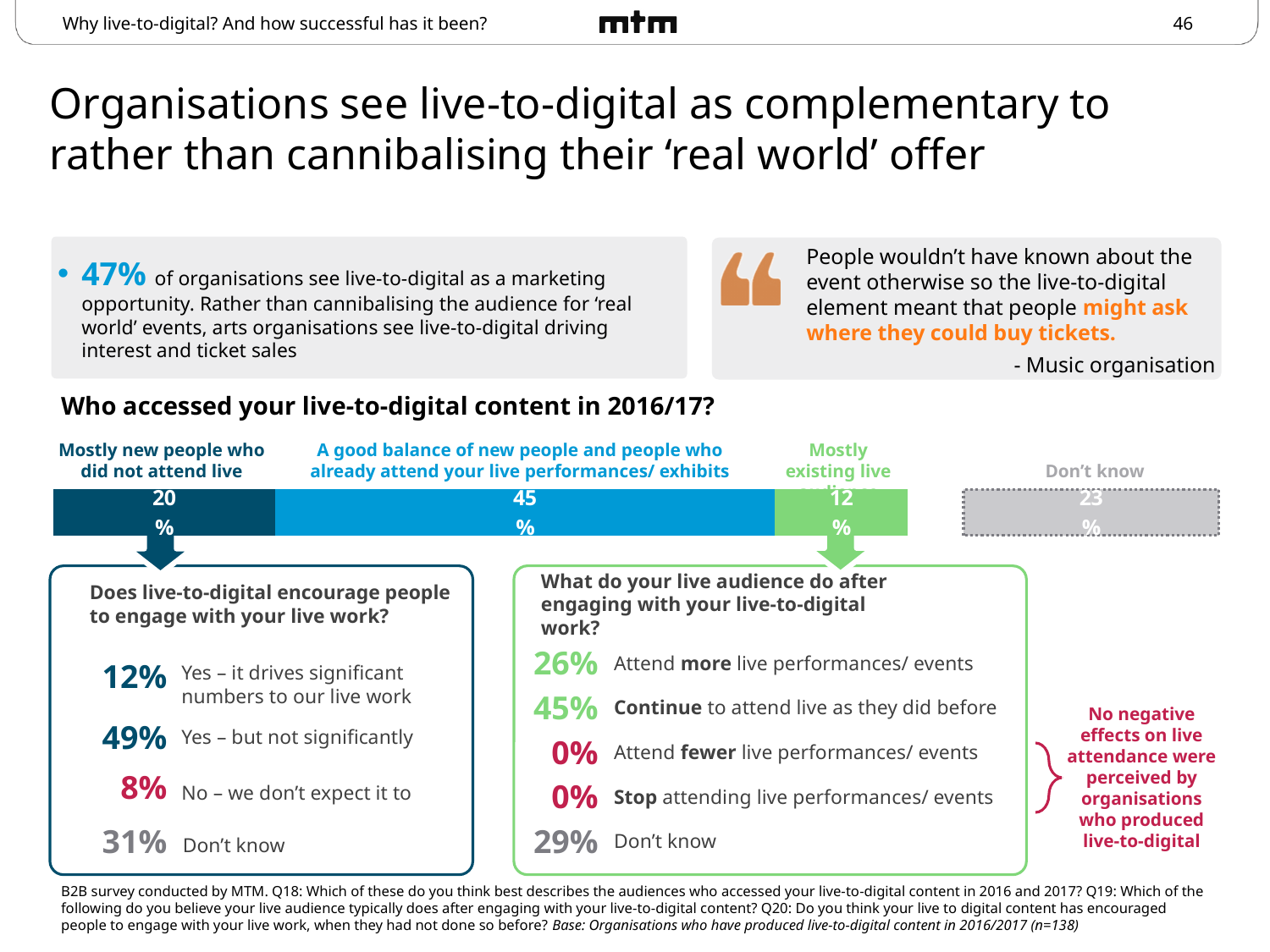
What type of chart is used for 'Who accessed your live-to-digital content in 2016/17?' Stacked bar chart In the 'Who accessed your live-to-digital content in 2016/17?' chart, what colour is the 'Mostly existing live audience' segment? Green In the 'Who accessed your live-to-digital content in 2016/17?' chart, what percentage is shown for 'A good balance of new people and people who already attend your live performances/ exhibits'? 45% How many segments make up the 'Who accessed your live-to-digital content in 2016/17?' bar? 4 In the 'Who accessed your live-to-digital content in 2016/17?' chart, which category has the largest share? A good balance of new people and people who already attend your live performances/ exhibits In the 'Who accessed your live-to-digital content in 2016/17?' chart, which is larger: 'Don't know' or 'Mostly new people who did not attend live'? Don't know In the 'Who accessed your live-to-digital content in 2016/17?' chart, which category has the smallest share? Mostly existing live audience In the 'Who accessed your live-to-digital content in 2016/17?' chart, what colour is the 'Don't know' segment? Grey In the 'Who accessed your live-to-digital content in 2016/17?' chart, what is the difference between the 'A good balance' segment and the 'Mostly new people who did not attend live' segment? 25% In the 'Who accessed your live-to-digital content in 2016/17?' chart, what percentage is shown for 'Don't know'? 23% In the 'Who accessed your live-to-digital content in 2016/17?' chart, what percentage is shown for 'Mostly new people who did not attend live'? 20% What is the total of all segments in the 'Who accessed your live-to-digital content in 2016/17?' bar? 100%